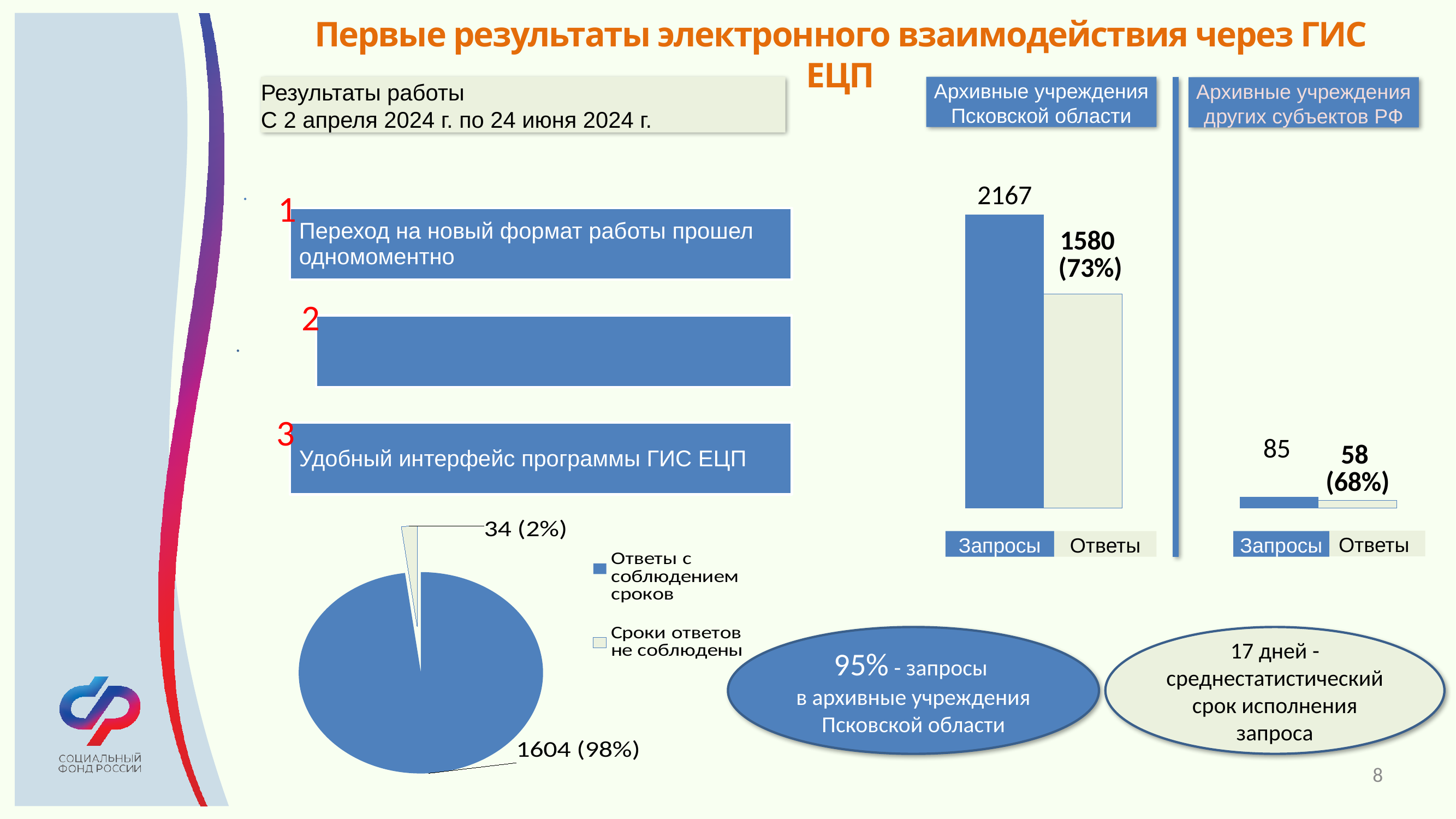
На диаграмме «Архивные учреждения Псковской области»: какое значение указано для ответов? 1580 (73%) На круговой диаграмме в нижней левой части слайда: какую долю составляет сегмент «Сроки ответов не соблюдены»? 2% На круговой диаграмме в нижней левой части слайда: какой сегмент больше — «Ответы с соблюдением сроков» или «Сроки ответов не соблюдены»? Ответы с соблюдением сроков На диаграмме «Архивные учреждения других субъектов РФ»: сколько запросов показано? 85 На диаграмме «Архивные учреждения других субъектов РФ»: какое значение указано для ответов? 58 (68%) На круговой диаграмме в нижней левой части слайда: какое значение указано для сегмента «Сроки ответов не соблюдены»? 34 (2%) На диаграмме «Архивные учреждения других субъектов РФ»: какого типа эта диаграмма? Столбчатая (bar chart) На круговой диаграмме в нижней левой части слайда: какое значение указано для сегмента «Ответы с соблюдением сроков»? 1604 (98%) На диаграмме «Архивные учреждения Псковской области»: на сколько число запросов больше числа ответов? 587 На диаграмме «Архивные учреждения Псковской области»: сколько запросов показано? 2167 Какого типа диаграмма расположена в нижней левой части слайда? Круговая диаграмма На круговой диаграмме в нижней левой части слайда: сколько сегментов показано? 2